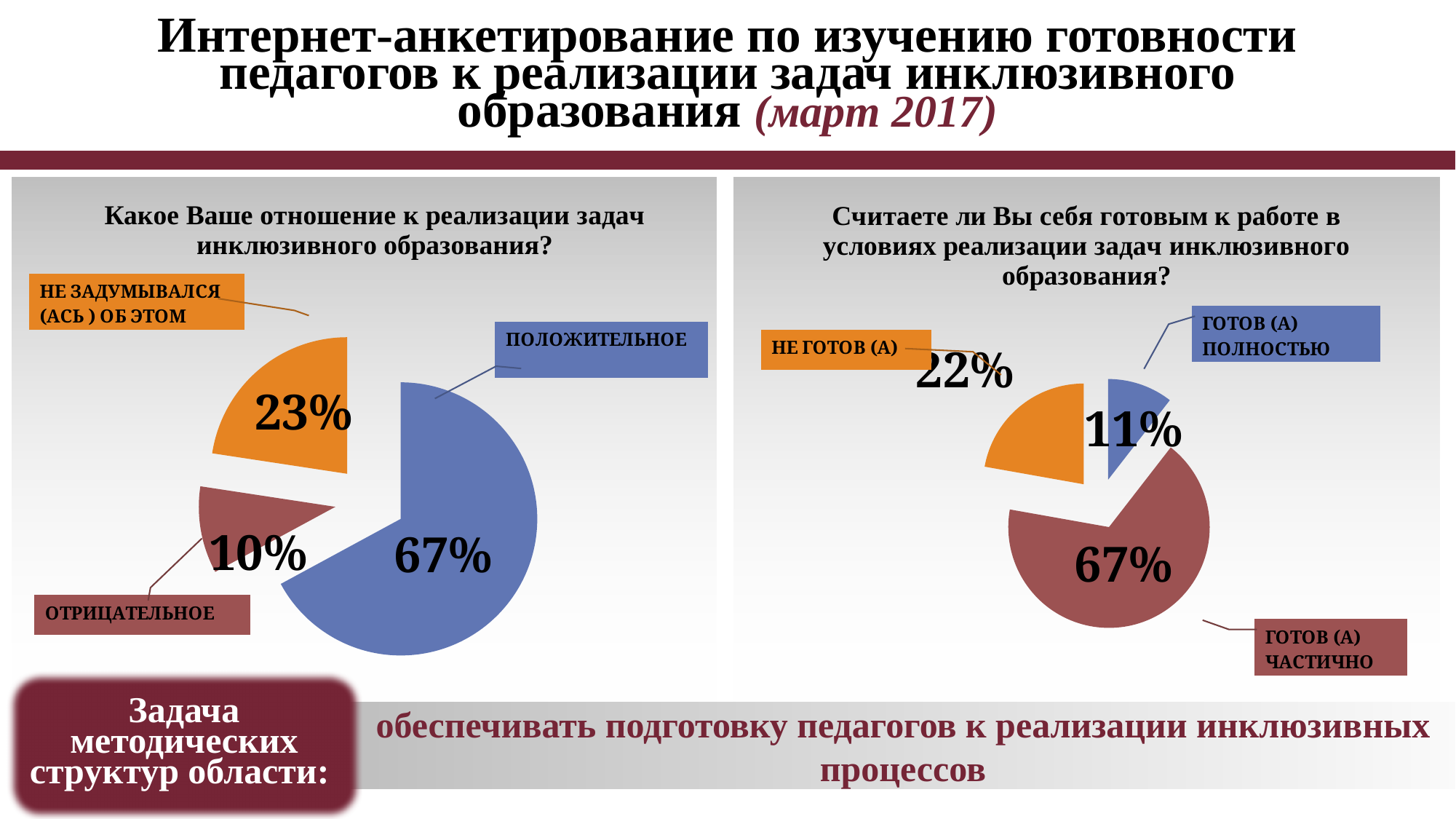
What type of chart is the left chart? Pie chart On the right chart, what is the difference in percentage points between "Не готов(а)" and "Готов(а) полностью"? 11 On the left chart, what share of respondents answered "Не задумывался(ась) об этом"? 23% On the right chart, what share of respondents answered "Не готов(а)"? 22% On the left chart, which answer has the smallest share? Отрицательное On the left chart, what share of respondents answered "Отрицательное"? 10% On the right chart, what share of respondents answered "Готов(а) частично"? 67% On the right chart, what share of respondents answered "Готов(а) полностью"? 11% On the left chart, which is larger: the share for "Не задумывался(ась) об этом" or the share for "Отрицательное"? Не задумывался(ась) об этом How many slices does the right chart have? 3 On the right chart, which answer has the largest share? Готов(а) частично On the left chart, what share of respondents answered "Положительное"? 67%